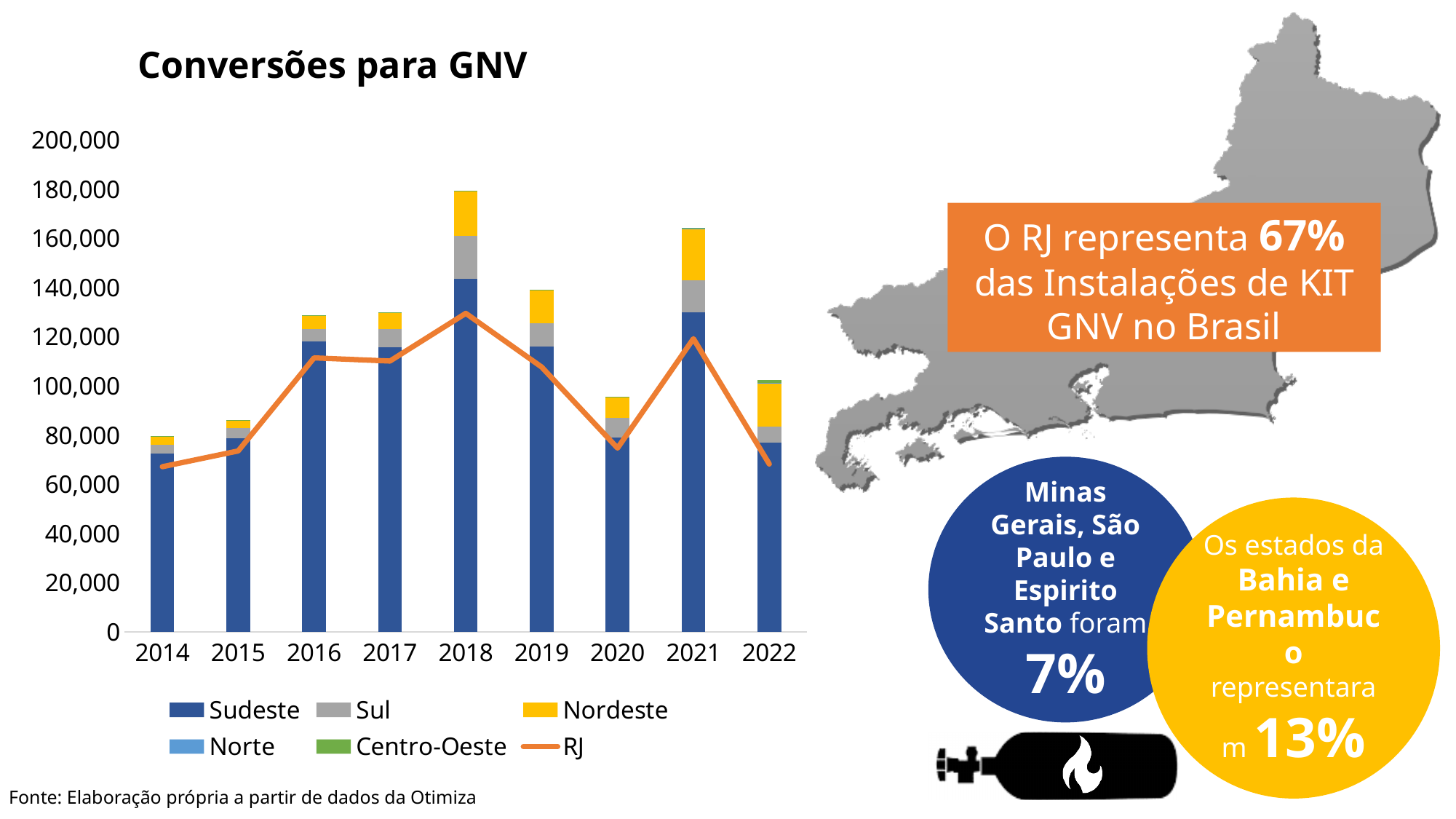
Is the RJ line value for 2018 greater or less than 120,000? greater What is the title of the chart? Conversões para GNV Which year has the tallest stacked bar? 2018 Which year has the larger total stacked bar, 2019 or 2021? 2021 How many years are shown on the x axis of the chart? 9 Which year has the shortest stacked bar? 2014 Is the total stacked bar for 2020 greater or less than 100,000? less Do the stacked bar totals rise or fall from 2018 to 2020? fall What kind of chart is shown on the slide? Stacked bar chart with a line Is the total stacked bar for 2018 greater or less than 160,000? greater How many series does the chart legend list? 6